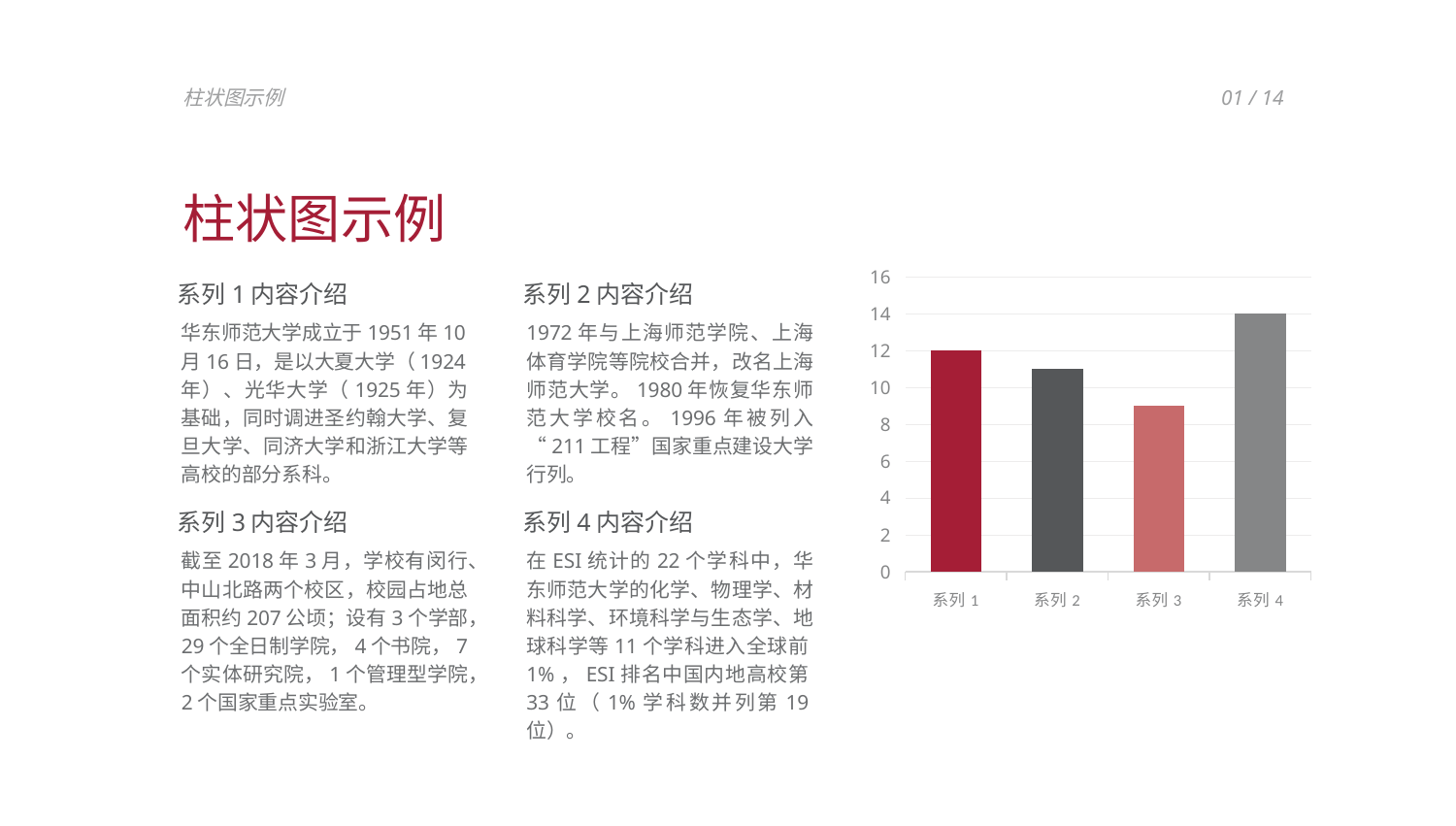
What is the value of the bar for 系列 4? 14 Which category has the highest bar? 系列 4 Is the value for 系列 2 greater or less than 10? greater What is the difference between the values for 系列 4 and 系列 1? 2 Which category has the lowest bar? 系列 3 What is the value of the bar for 系列 1? 12 Is the value for 系列 3 greater or less than 10? less How many bars (categories) are plotted in the chart? 4 What type of chart is shown on the slide? Bar chart What is the highest value shown on the vertical axis? 16 What colour is the bar for 系列 1? Dark red Which is larger, the value for 系列 4 or the value for 系列 3? 系列 4